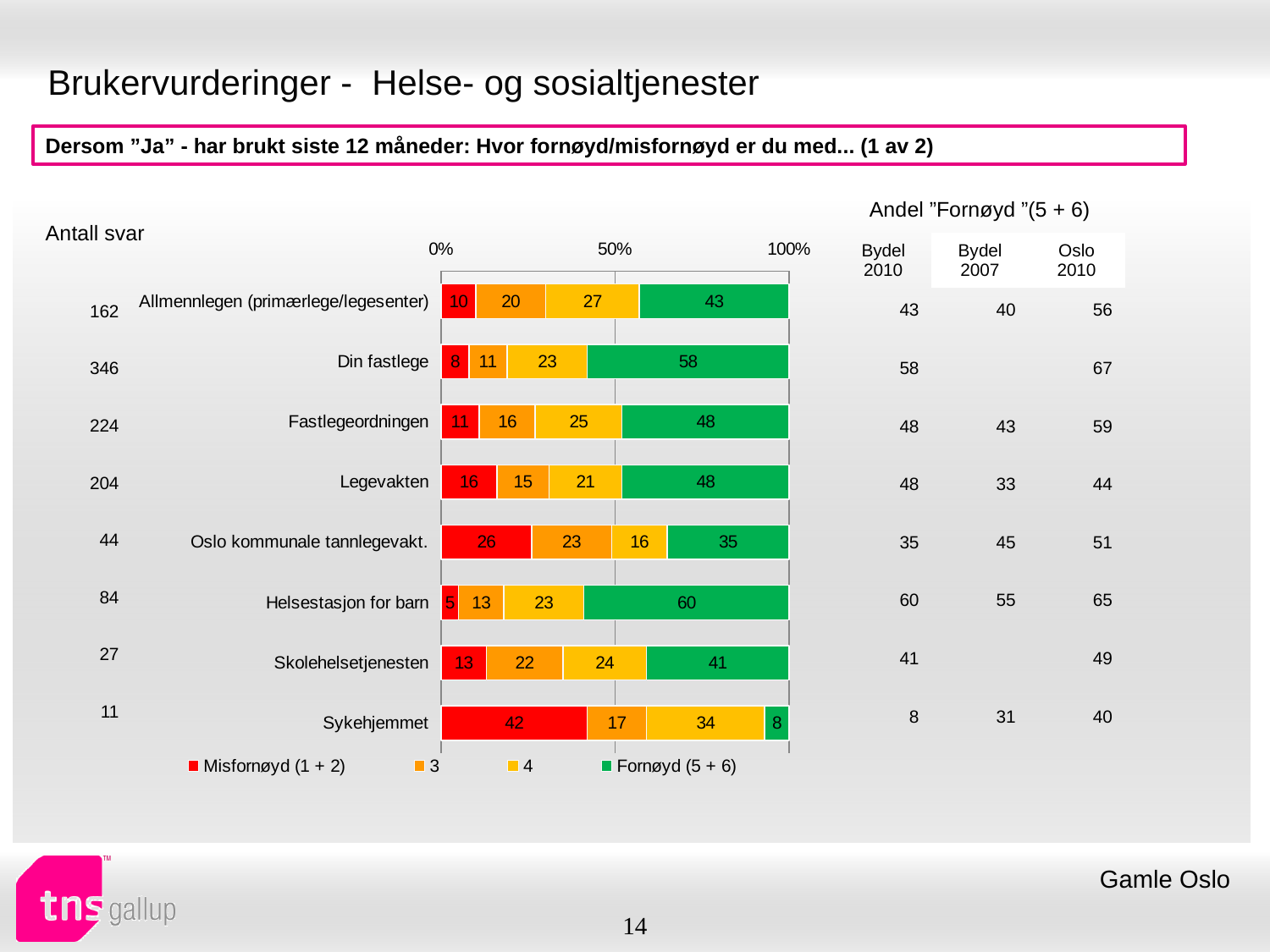
What is the value of the '4' segment for Legevakten? 21 What is the difference between the Fornøyd (5 + 6) values for Din fastlege and Allmennlegen (primærlege/legesenter)? 15 What is the value of the Misfornøyd (1 + 2) segment for Sykehjemmet? 42 What is the value of the '3' segment for Skolehelsetjenesten? 22 What kind of chart is shown on the slide? Stacked bar chart What is the total of the stacked bar for Allmennlegen (primærlege/legesenter)? 100 How many categories are shown in the bar chart? 8 Which has a larger Misfornøyd (1 + 2) value, Legevakten or Helsestasjon for barn? Legevakten What is the value of the Fornøyd (5 + 6) segment for Din fastlege? 58 How many series does the legend list? 4 Which category has the highest Fornøyd (5 + 6) value? Helsestasjon for barn Which category has the lowest Fornøyd (5 + 6) value? Sykehjemmet